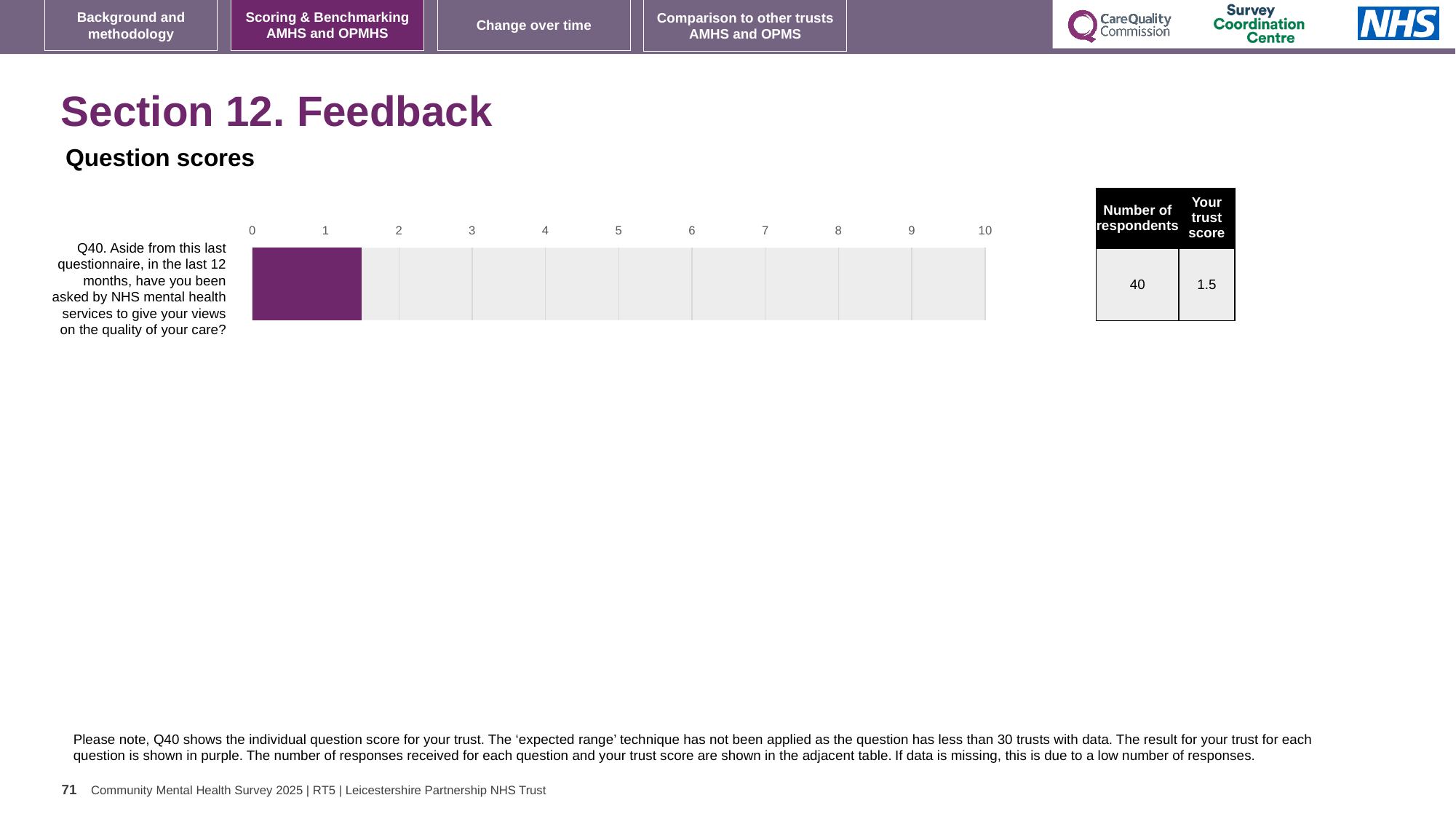
Is the value for Q40 greater or less than 5? less What is the maximum value shown on the chart's axis? 10 What colour is the bar for Q40 on the chart? Purple What kind of chart is shown on the slide? Bar chart How many respondents answered Q40 according to the table next to the chart? 40 Is the value for Q40 greater or less than 2? less Is the value for Q40 greater or less than 1? greater How many questions (categories) are plotted on the chart? 1 What is the trust score for Q40 shown on the chart? 1.5